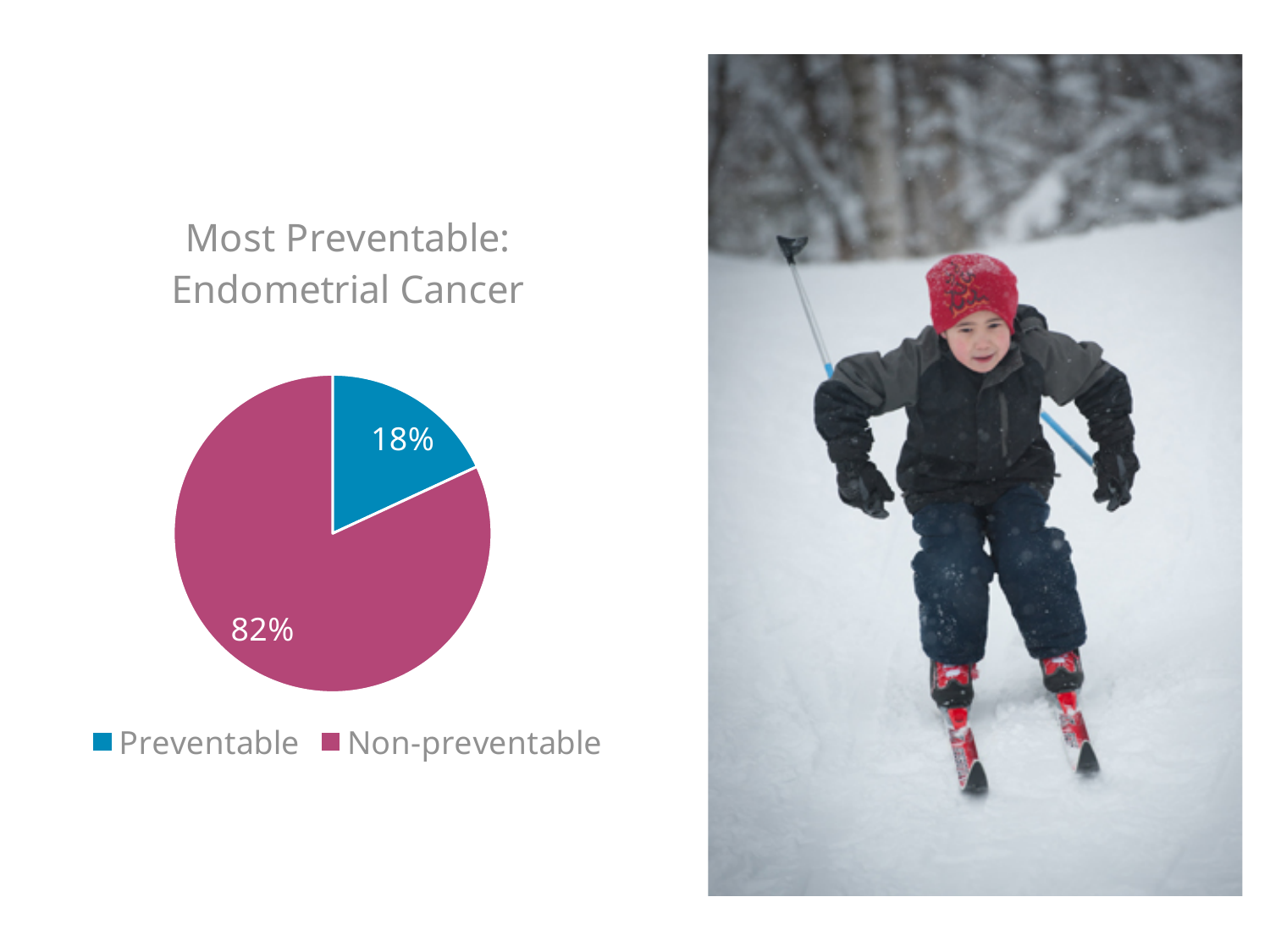
What is the title of the chart? Most Preventable: Endometrial Cancer What colour is the Non-preventable slice in the pie chart? Magenta/pink What is the difference in percentage points between the Non-preventable and Preventable slices? 64 How many slices does the pie chart have? 2 Which slice of the pie chart is the largest? Non-preventable Which slice of the pie chart is the smallest? Preventable What kind of chart is shown on the slide? Pie chart Which is larger, the Preventable slice or the Non-preventable slice? Non-preventable What percentage of the pie chart is labelled Non-preventable? 82% What percentage of the pie chart is labelled Preventable? 18% How many entries does the chart legend list? 2 What share of the pie does the Preventable slice represent? 18%